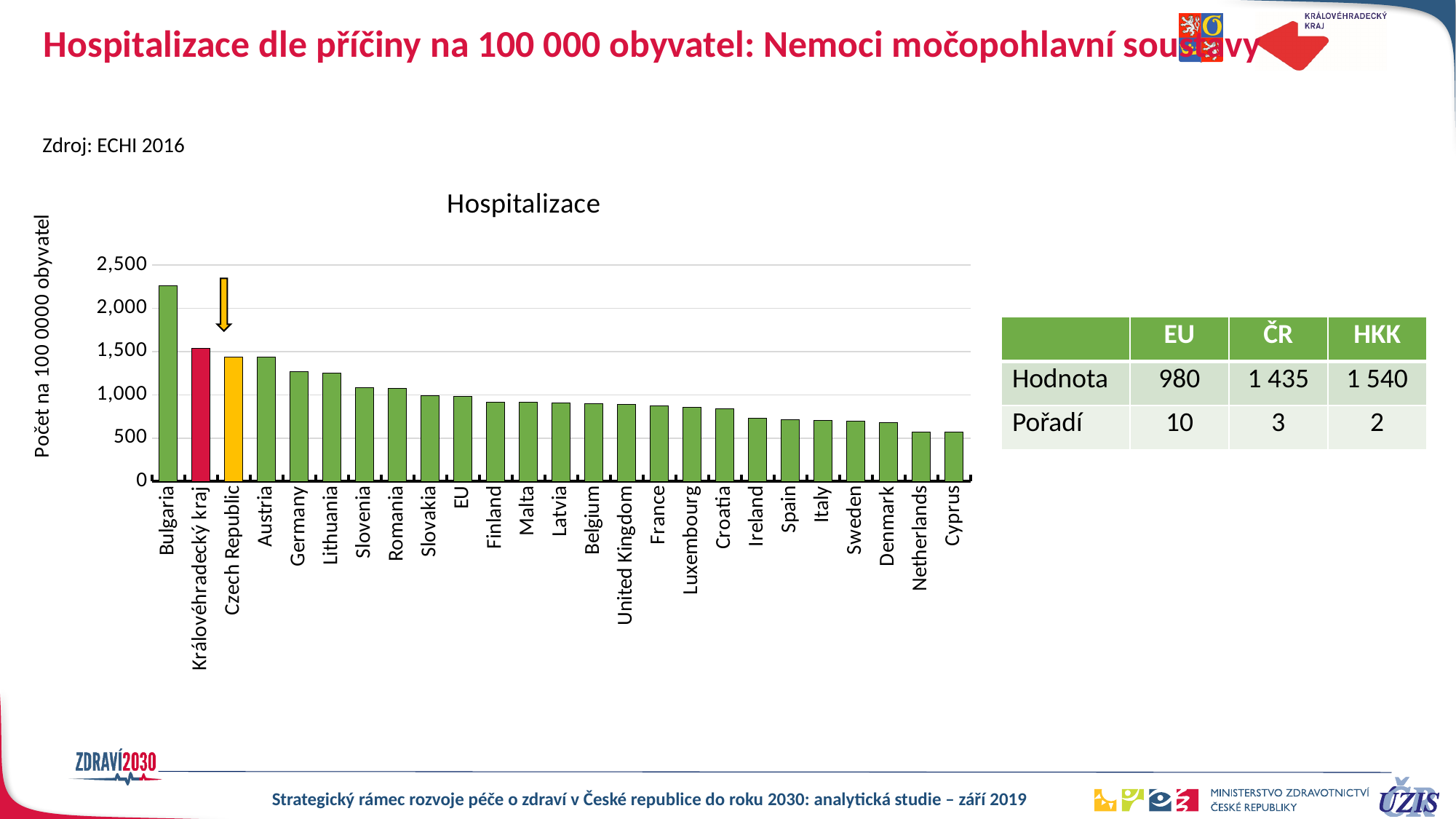
Is the value for Ireland greater or less than 1,000? less Which category has the highest value in the Hospitalizace chart? Bulgaria Is the value for Germany greater or less than 1,000? greater Do the values rise or fall moving from left to right along the x axis? fall What kind of chart is shown on the slide? bar chart Is the value for Austria greater or less than 1,500? less Which is larger, the value for Bulgaria or the value for Austria? Bulgaria According to the table on the slide, what is the value (Hodnota) for HKK? 1 540 According to the table on the slide, what is the value (Hodnota) for the EU? 980 What is the title of the chart? Hospitalizace How many categories are plotted on the x axis of the Hospitalizace chart? 25